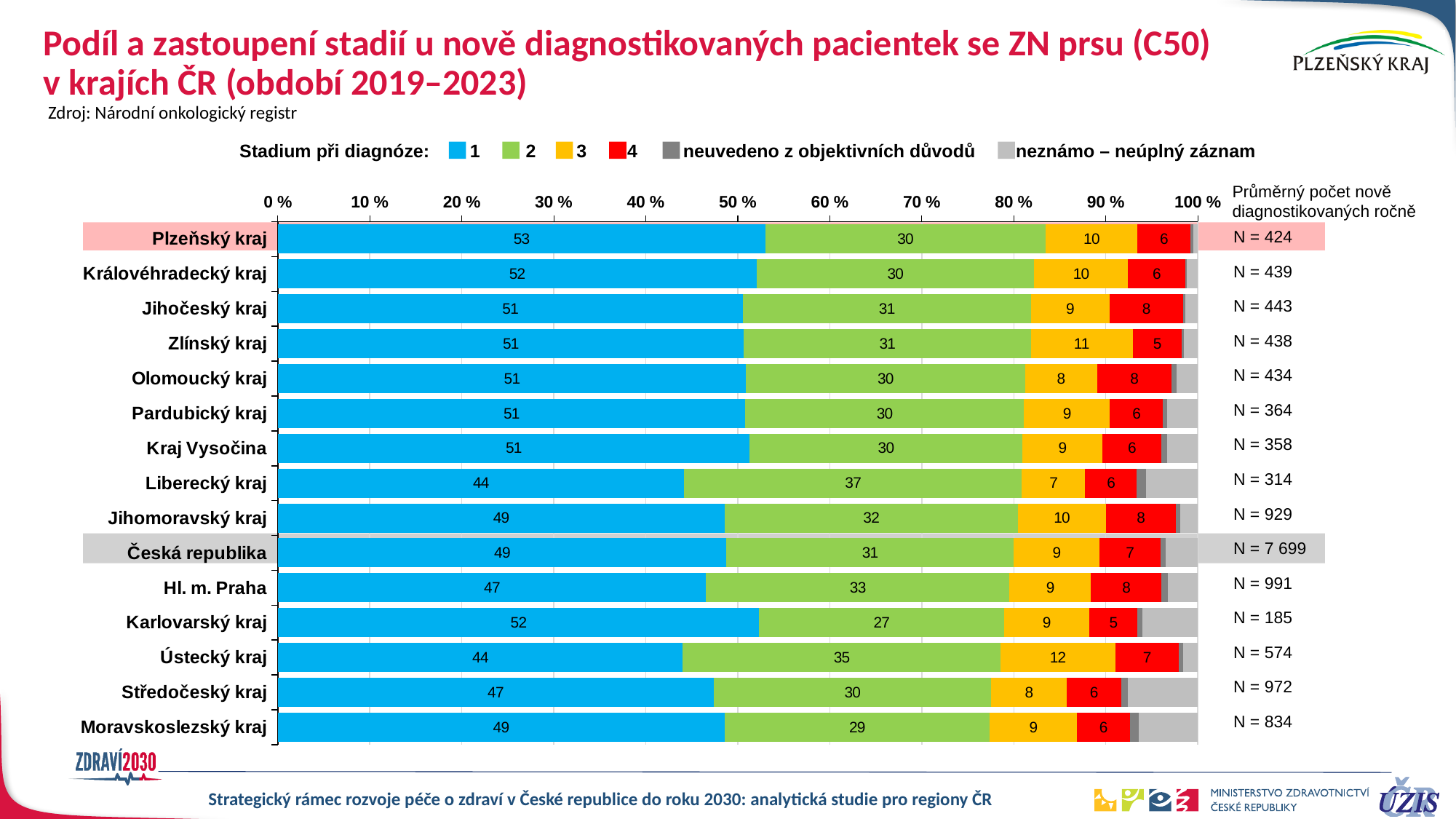
How many bars (regions including Česká republika) are shown in the chart? 15 What is the stage 4 value for Jihočeský kraj? 8 What percentage of newly diagnosed patients in Plzeňský kraj were diagnosed at stage 1? 53 How many series does the legend list? 6 What is the stage 3 value for Ústecký kraj? 12 Which region has the highest share of stage 2 diagnoses? Liberecký kraj How much higher is the stage 1 share for Plzeňský kraj than for Česká republika? 4 What is the stage 2 value for Liberecký kraj? 37 What kind of chart is shown on the slide? Stacked bar chart Which has a larger stage 1 share, Karlovarský kraj or Hl. m. Praha? Karlovarský kraj Which region has the lowest share of stage 2 diagnoses? Karlovarský kraj Which region has the highest share of stage 1 diagnoses? Plzeňský kraj